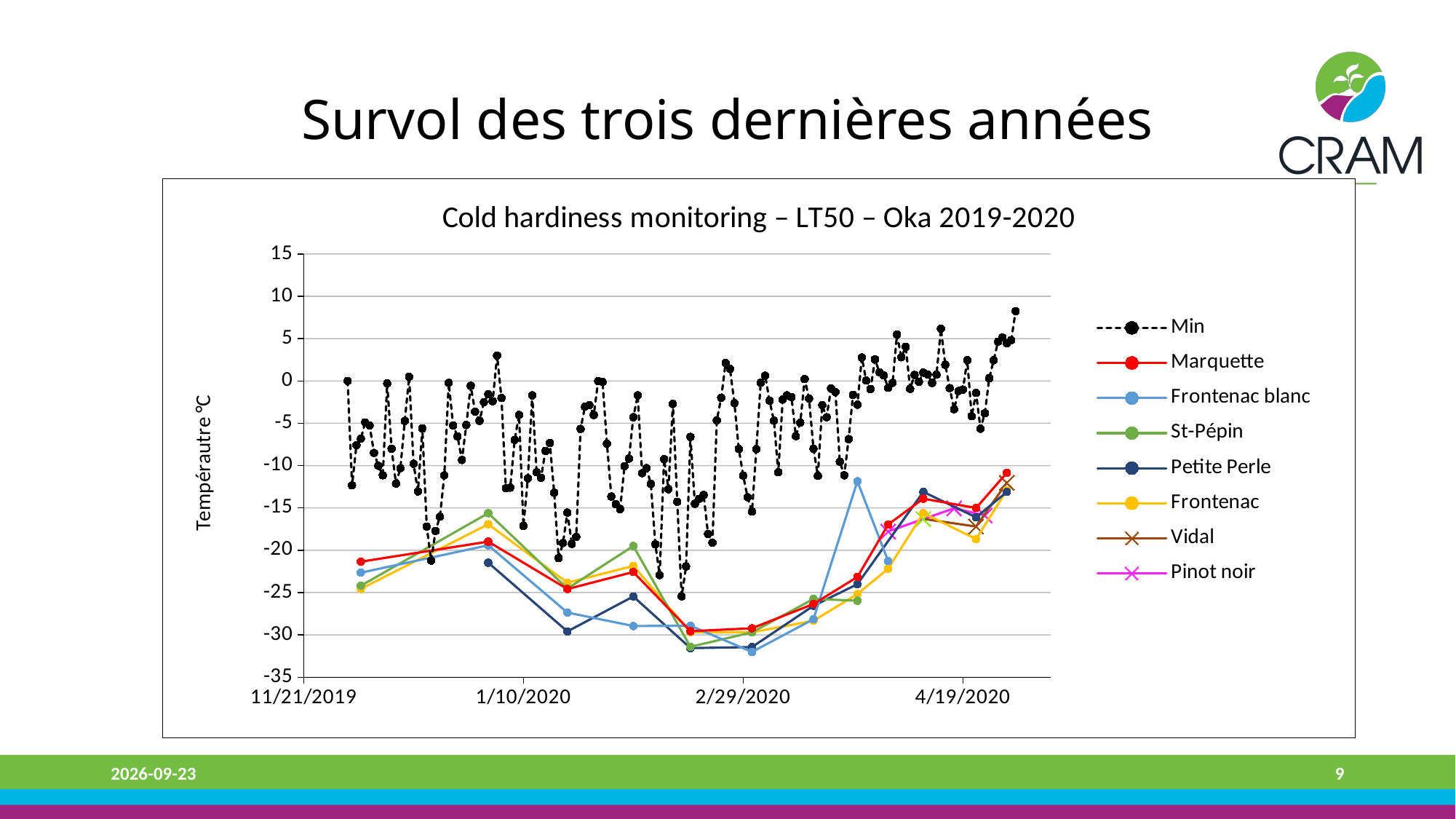
Do the cultivar LT50 series rise or fall between 1/10/2020 and 2/29/2020? fall How many series does the legend list? 8 Which series in the legend is drawn with a dashed black line? Min Is the first plotted value of the St-Pépin series greater or less than -20? less Is the lowest value of the Frontenac blanc series greater or less than -30? less How many date labels are shown on the x axis? 4 What kind of chart is shown on the slide? line chart Do the cultivar LT50 series rise or fall between 2/29/2020 and 4/19/2020? rise Is the last plotted value of the Marquette series greater or less than -15? greater What is the title of the chart? Cold hardiness monitoring – LT50 – Oka 2019-2020